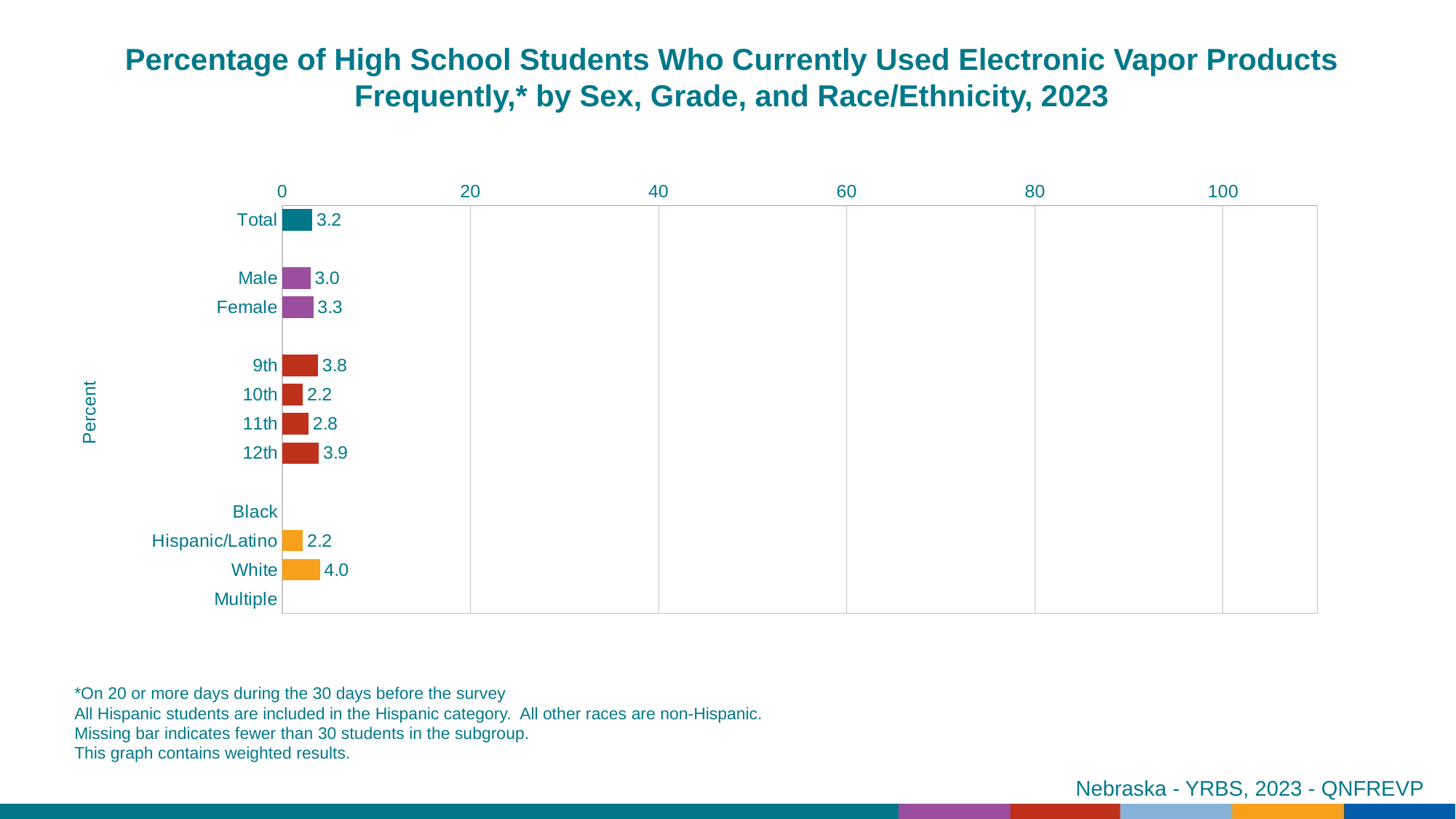
What kind of chart is shown on the slide? bar chart Which is larger, the value for Male or the value for Female? Female What is the value for 12th grade? 3.9 Which grade has the lowest value? 10th What is the value for Total? 3.2 What is the difference between the values for 9th and 10th grade? 1.6 Which category has the highest value on the chart? White What is the value for Hispanic/Latino? 2.2 Which categories have no bar shown? Black and Multiple What is the label on the vertical axis? Percent What is the value for Female? 3.3 Is the value for White greater or less than 20? less